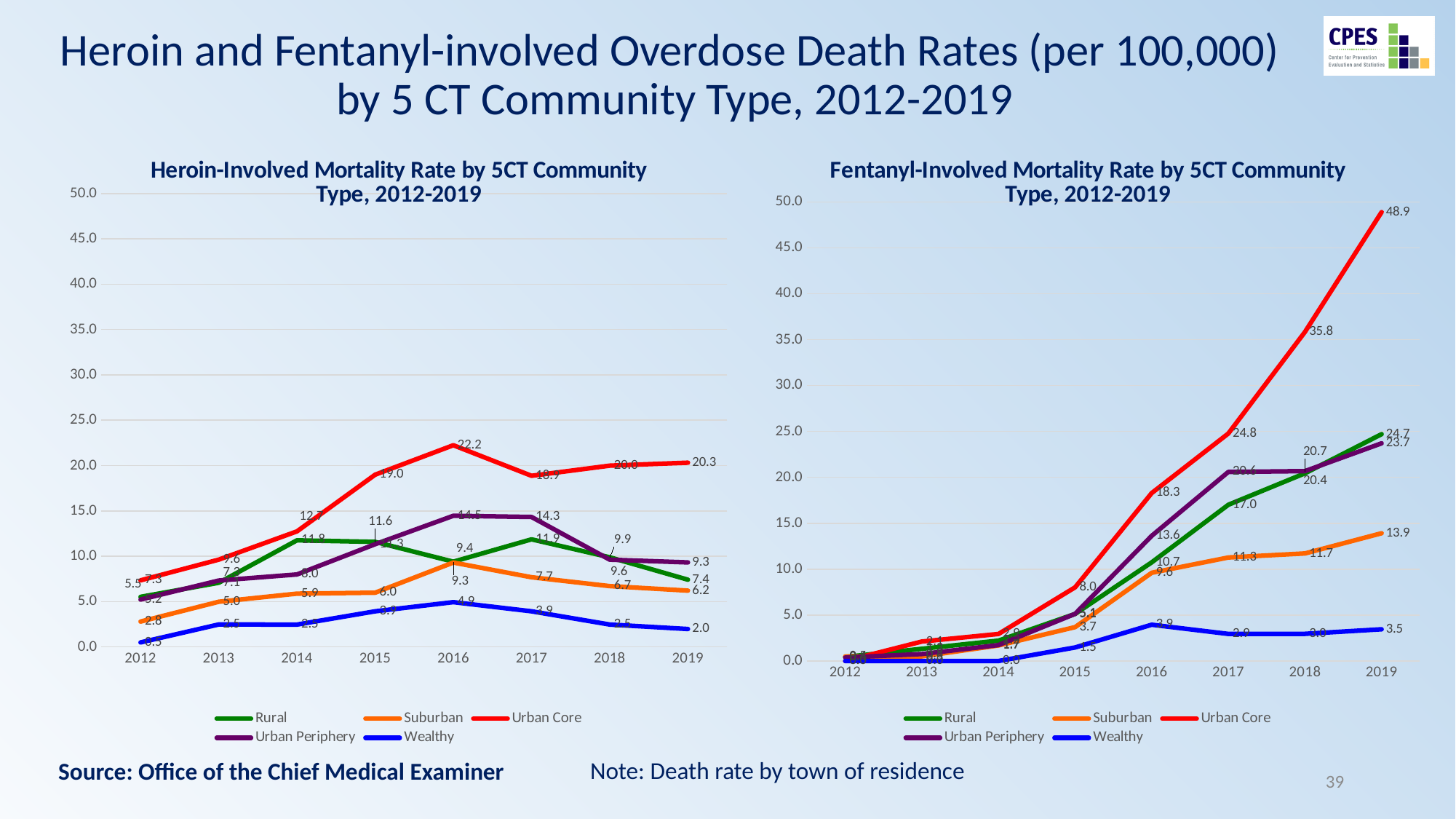
In the Fentanyl-Involved Mortality Rate chart, which community type has the lowest value in 2019? Wealthy In the Fentanyl-Involved Mortality Rate chart, does the Urban Core line rise or fall from 2015 to 2019? Rise In the Fentanyl-Involved Mortality Rate chart, what is the Suburban value for 2019? 13.9 What kind of chart is the Fentanyl-Involved Mortality Rate chart? Line chart In the Fentanyl-Involved Mortality Rate chart, what is the Urban Core value for 2019? 48.9 In the Fentanyl-Involved Mortality Rate chart, is the Urban Core value for 2018 greater or less than 30.0? greater In the Heroin-Involved Mortality Rate chart, which community type has the highest value in 2019? Urban Core How many series does the legend of the Fentanyl-Involved Mortality Rate chart list? 5 In the Heroin-Involved Mortality Rate chart, what is the Urban Core value for 2016? 22.2 In the Heroin-Involved Mortality Rate chart, which is larger in 2019: the Rural value or the Suburban value? Rural In the Fentanyl-Involved Mortality Rate chart, what is the difference between the Urban Core values for 2019 and 2018? 13.1 How many years are shown on the x axis of the Heroin-Involved Mortality Rate chart? 8